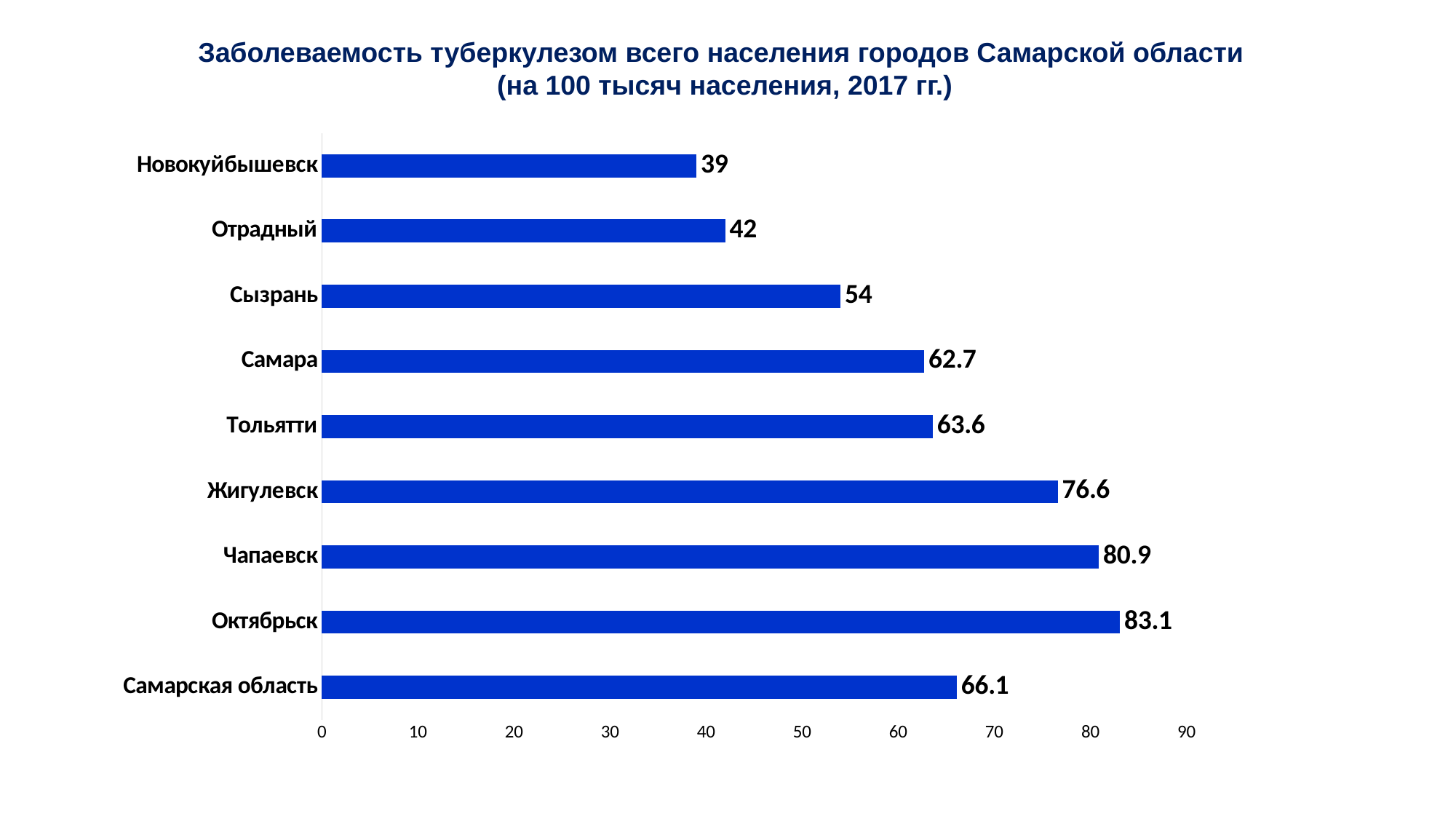
What is the value for Самарская область? 66.1 Is the value for Чапаевск greater or less than 80? greater Which is larger, the value for Жигулевск or the value for Тольятти? Жигулевск What kind of chart is shown on the slide? bar chart What is the value for Самара? 62.7 What is the title of the chart? Заболеваемость туберкулезом всего населения городов Самарской области (на 100 тысяч населения, 2017 гг.) Which category has the lowest value? Новокуйбышевск What is the value for Новокуйбышевск? 39 What is the difference between the values for Октябрьск and Чапаевск? 2.2 Which category has the highest value? Октябрьск How many categories are shown on the chart? 9 What is the difference between the values for Сызрань and Отрадный? 12